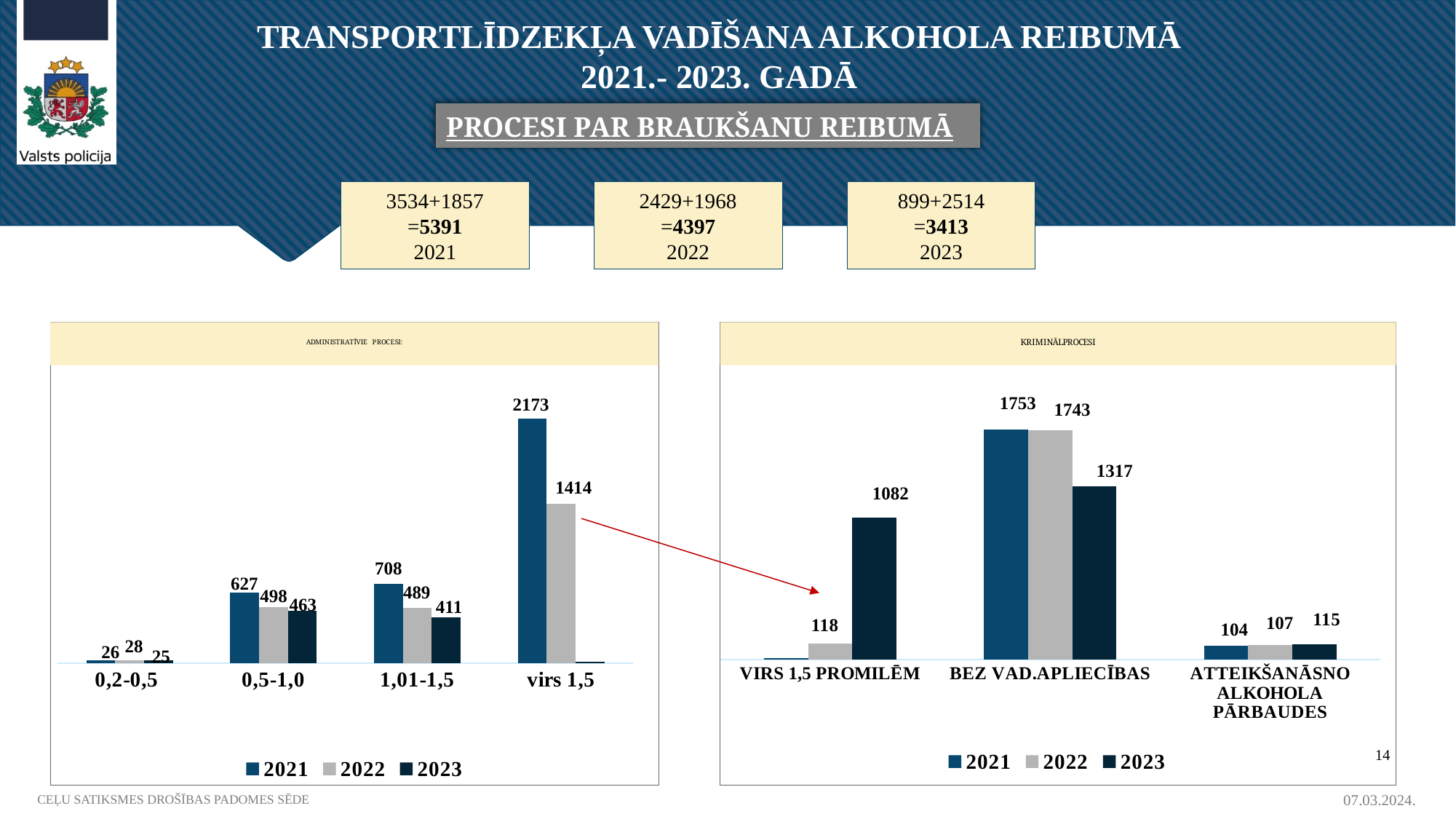
What type of chart is the right chart (KRIMINĀLPROCESI)? Bar chart In the left chart (ADMINISTRATĪVIE PROCESI), which category has the highest 2021 value? virs 1,5 In the left chart (ADMINISTRATĪVIE PROCESI), how many categories are shown on the x axis? 4 In the left chart (ADMINISTRATĪVIE PROCESI), what is the value for 2022 in the '0,5-1,0' category? 498 In the right chart (KRIMINĀLPROCESI), what is the difference between the 2022 and 2023 values in the 'BEZ VAD.APLIECĪBAS' category? 426 In the right chart (KRIMINĀLPROCESI), what is the value for 2023 in the 'VIRS 1,5 PROMILĒM' category? 1082 In the left chart (ADMINISTRATĪVIE PROCESI), what is the value for 2021 in the 'virs 1,5' category? 2173 In the left chart (ADMINISTRATĪVIE PROCESI), what is the value for 2023 in the '1,01-1,5' category? 411 In the right chart (KRIMINĀLPROCESI), what is the value for 2021 in the 'BEZ VAD.APLIECĪBAS' category? 1753 In the left chart (ADMINISTRATĪVIE PROCESI), what is the difference between the 2021 and 2022 values in the 'virs 1,5' category? 759 In the right chart (KRIMINĀLPROCESI), which is larger in the 'ATTEIKŠANĀS NO ALKOHOLA PĀRBAUDES' category: the 2021 value or the 2023 value? 2023 In the right chart (KRIMINĀLPROCESI), how many series does the legend list? 3